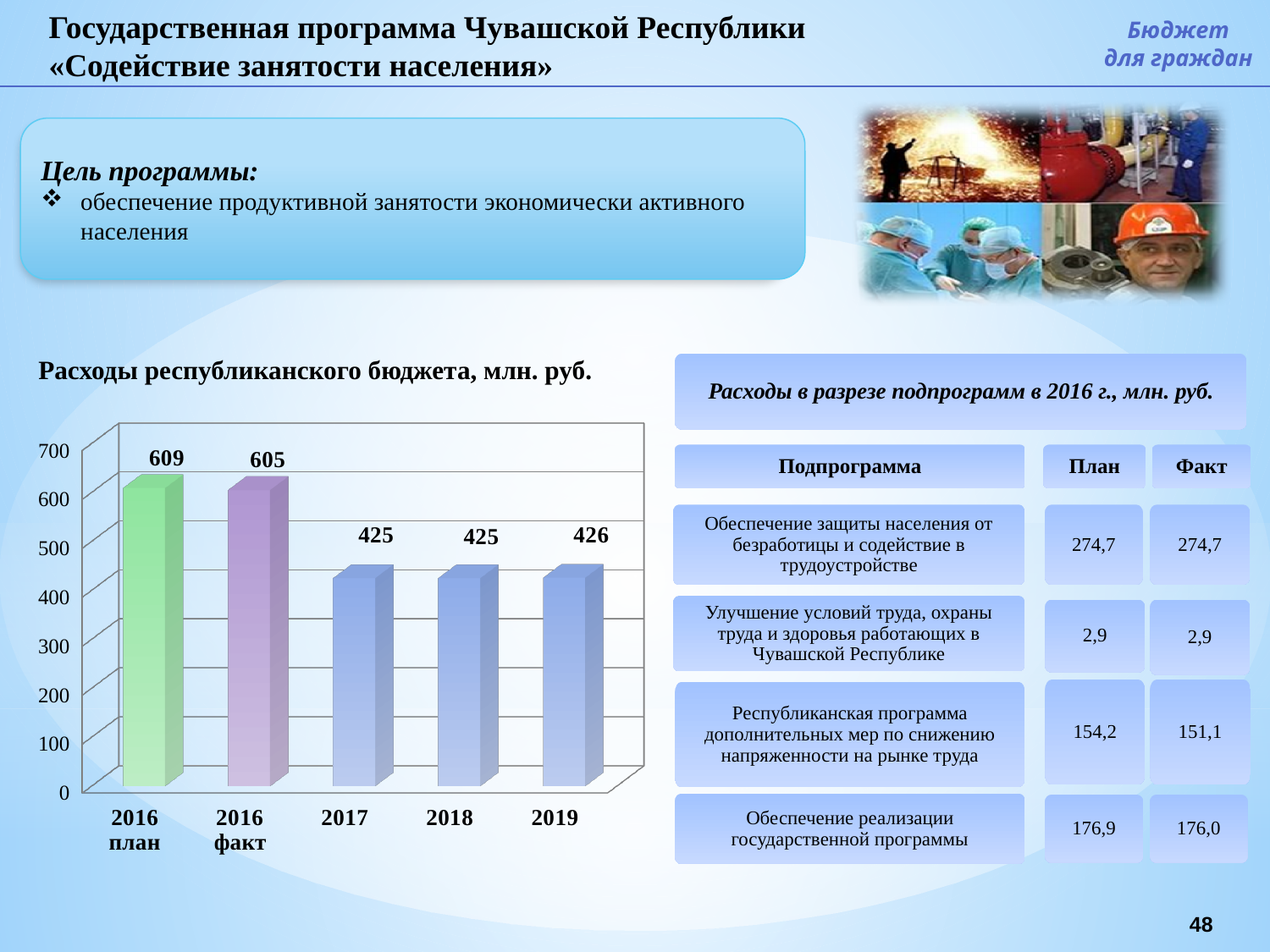
Is the value for 2018 greater or less than 500? less What is the difference between the values for 2016 план and 2016 факт? 4 What is the value for 2017 in the chart? 425 What is the title of the chart? Расходы республиканского бюджета, млн. руб. What is the difference between the values for 2016 факт and 2017? 180 What is the value for 2016 план in the chart? 609 Which category has the highest value in the chart? 2016 план How many categories are shown on the x axis of the chart? 5 What is the value for 2019 in the chart? 426 What kind of chart is shown on the slide? bar chart Which is larger, the value for 2016 план or the value for 2018? 2016 план What is the value for 2016 факт in the chart? 605